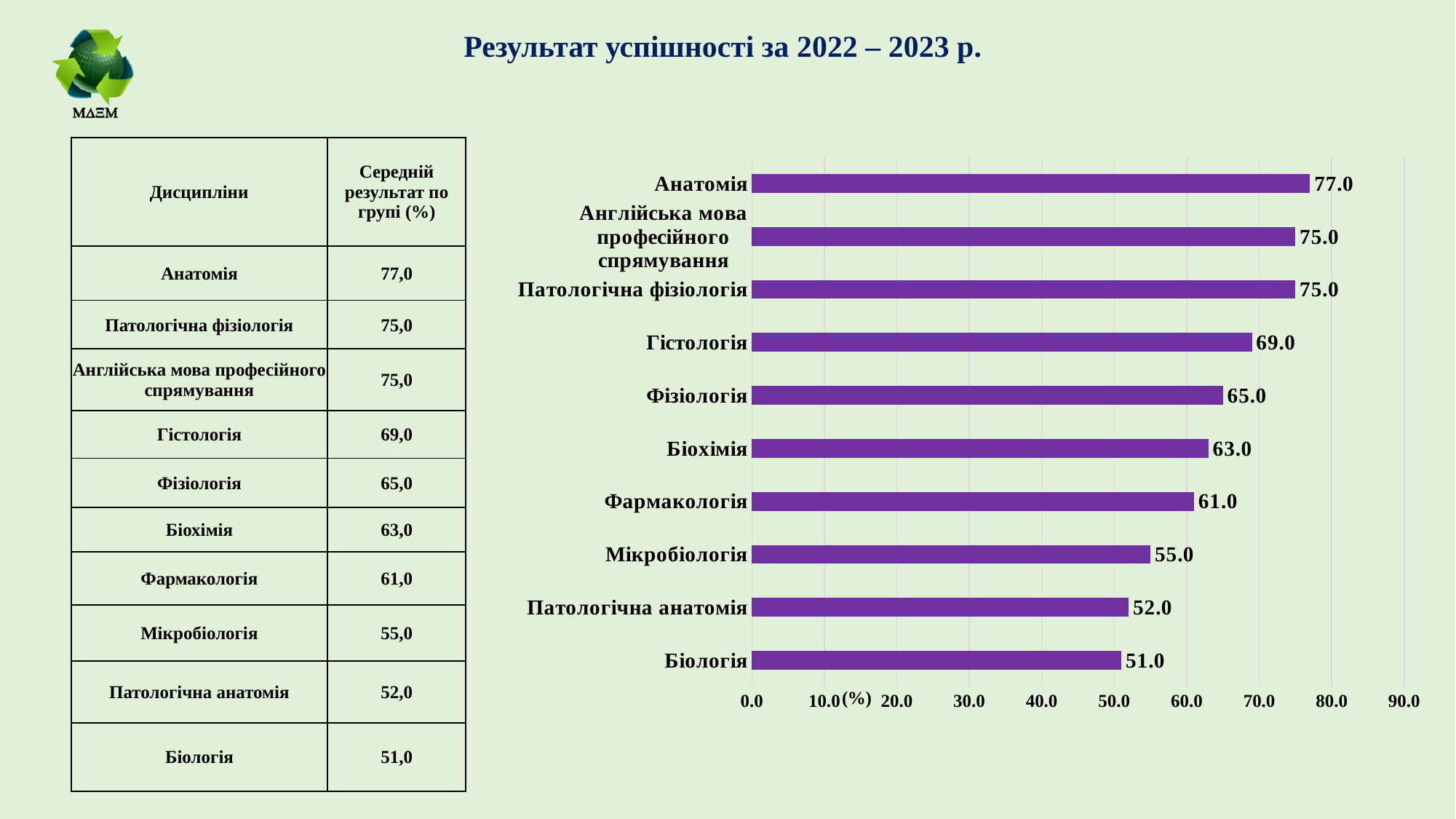
Which category has the lowest value in the bar chart? Біологія What is the value shown for Анатомія in the bar chart? 77.0 How many categories are shown in the bar chart? 10 What type of chart is shown on the slide? bar chart What is the value shown for Мікробіологія in the bar chart? 55.0 What is the difference between the values for Анатомія and Біологія in the bar chart? 26.0 What is the value shown for Гістологія in the bar chart? 69.0 What is the title of the slide containing the bar chart? Результат успішності за 2022 – 2023 р. What is the difference between the values for Фізіологія and Біохімія in the bar chart? 2.0 Is the value for Патологічна анатомія in the bar chart greater or less than 60.0? less Which category has the highest value in the bar chart? Анатомія Which has a larger value in the bar chart, Фармакологія or Мікробіологія? Фармакологія